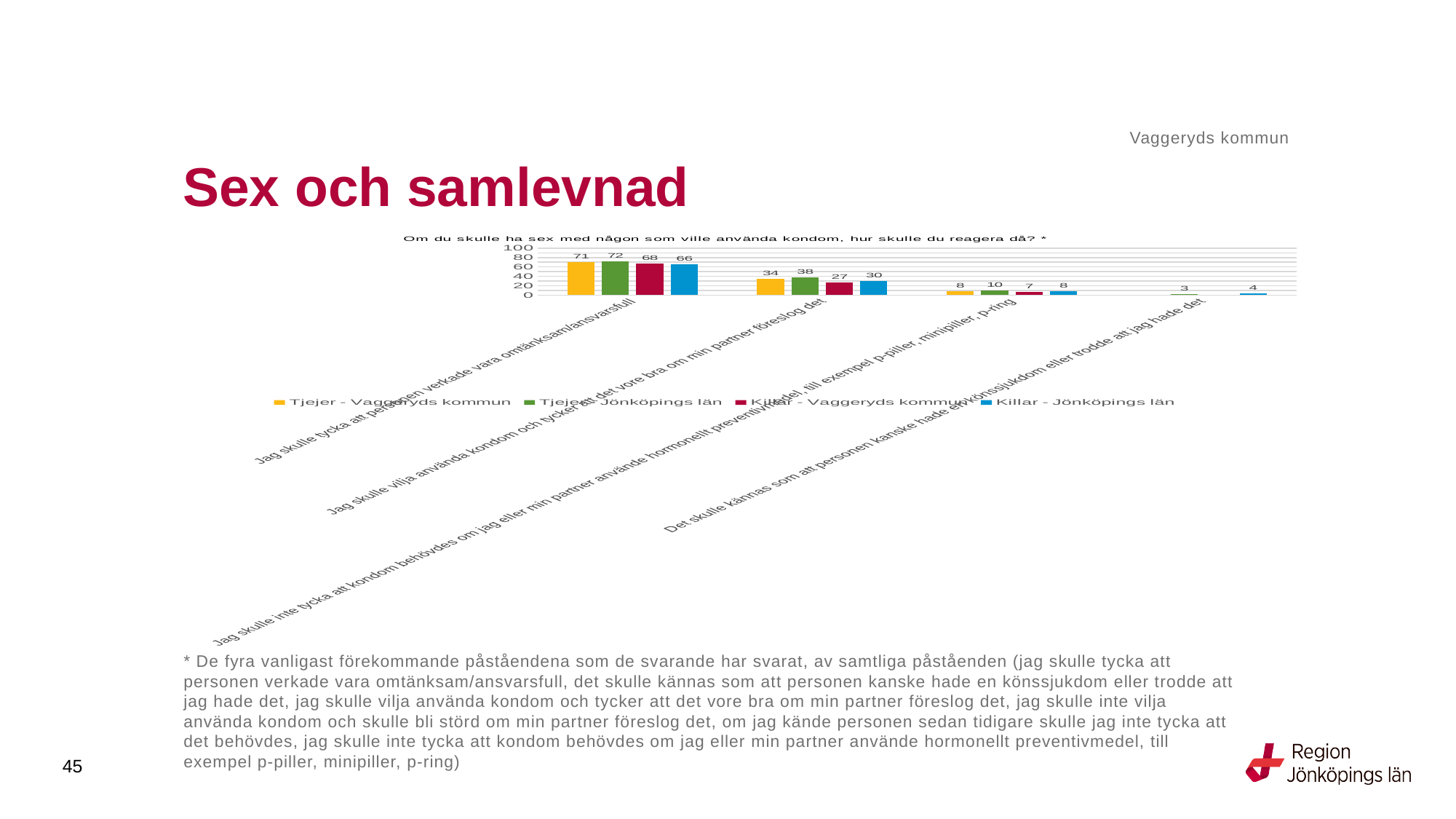
Which colour represents Killar - Vaggeryds kommun in the legend? red Is the value for Killar - Vaggeryds kommun for "Jag skulle tycka att personen verkade vara omtänksam/ansvarsfull" greater or less than 60? greater Which series has the lowest value for "Jag skulle tycka att personen verkade vara omtänksam/ansvarsfull"? Killar - Jönköpings län How many series does the legend list? 4 What is the difference between Tjejer - Jönköpings län and Killar - Vaggeryds kommun for "Jag skulle vilja använda kondom och tycker att det vore bra om min partner föreslog det"? 11 What is the value for Killar - Jönköpings län for "Det skulle kännas som att personen kanske hade en könssjukdom eller trodde att jag hade det"? 4 What is the value for Killar - Jönköpings län for "Jag skulle vilja använda kondom och tycker att det vore bra om min partner föreslog det"? 30 What type of chart is shown on the slide? bar chart Which is larger for "Jag skulle inte tycka att kondom behövdes om jag eller min partner använde hormonellt preventivmedel": Tjejer - Jönköpings län or Killar - Vaggeryds kommun? Tjejer - Jönköpings län Which series has the highest value for "Jag skulle vilja använda kondom och tycker att det vore bra om min partner föreslog det"? Tjejer - Jönköpings län What is the value for Tjejer - Vaggeryds kommun for "Jag skulle tycka att personen verkade vara omtänksam/ansvarsfull"? 71 What is the value for Tjejer - Jönköpings län for "Det skulle kännas som att personen kanske hade en könssjukdom eller trodde att jag hade det"? 3